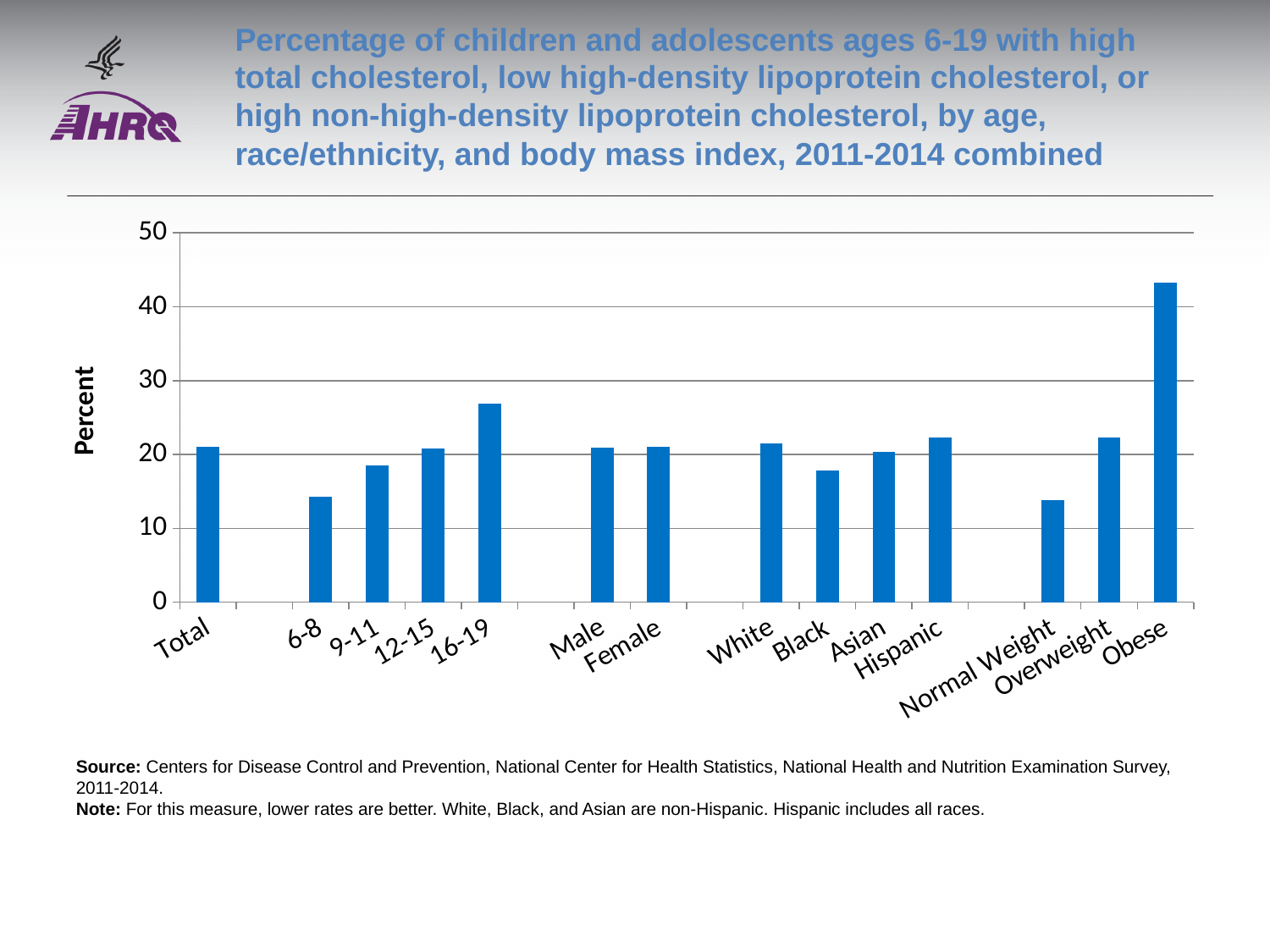
Is the value for 6-8 greater or less than 10? greater Which is larger, the value for White or the value for Black? White Which category has the highest percentage? Obese What is the label on the vertical axis of the chart? Percent How many bars (categories) are plotted in the chart? 14 Which is larger, the value for Obese or the value for Overweight? Obese Is the value for 16-19 greater or less than 30? less Is the value for Black greater or less than 20? less What kind of chart is shown on the slide? bar chart Which is larger, the value for 16-19 or the value for 6-8? 16-19